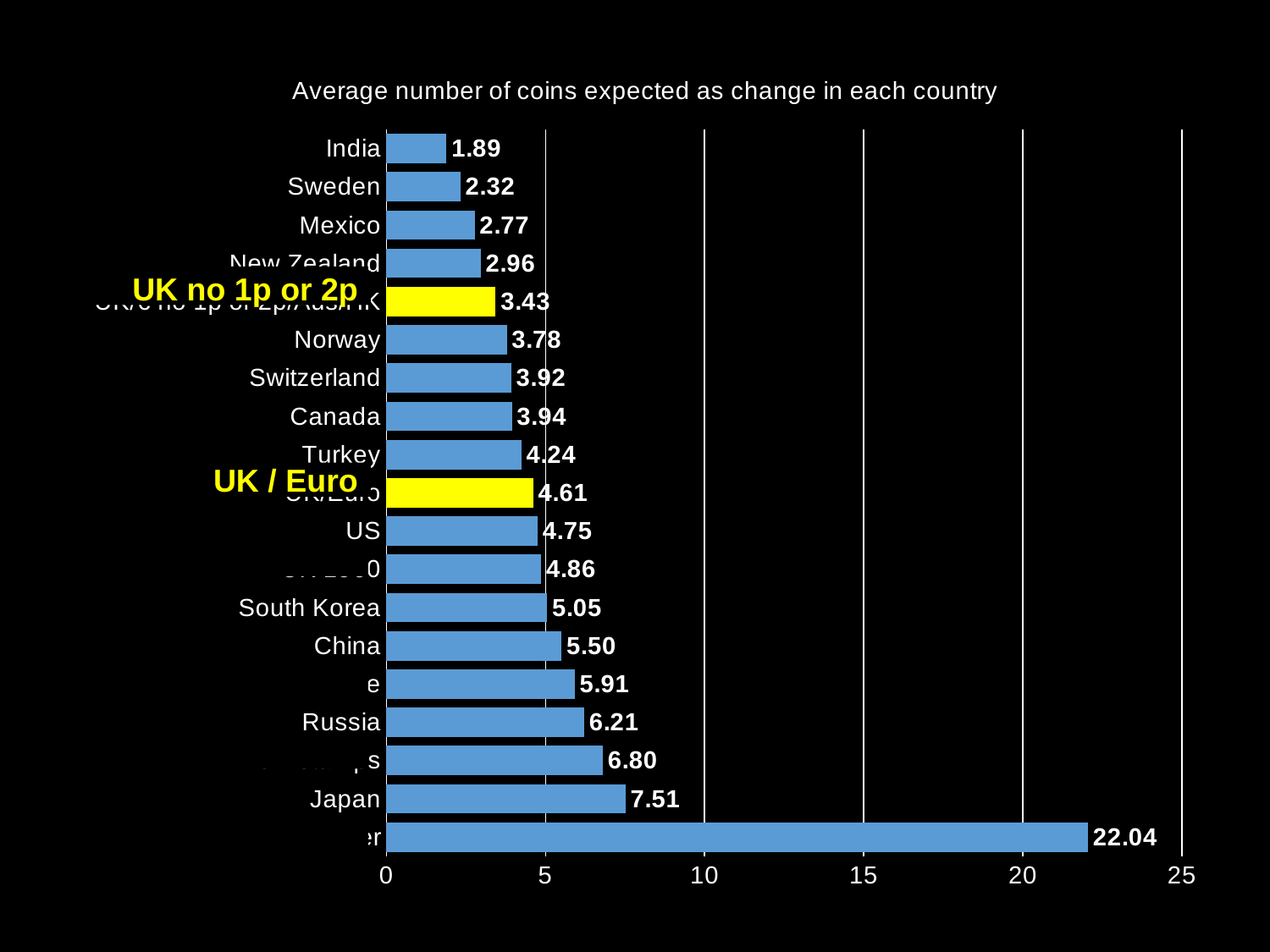
Which country has the lowest average number of coins expected as change? India How many bars are shown on the chart? 19 What is the average number of coins expected as change in India? 1.89 What is the largest value shown on the chart? 22.04 What is the value for the 'UK / Euro' bar? 4.61 What is the difference between the values for Japan and Russia? 1.30 Is the value for Russia greater or less than 5? greater What type of chart is shown on the slide? Bar chart Which has a higher value, China or South Korea? China What is the title of the chart? Average number of coins expected as change in each country What value is shown for Japan? 7.51 What is the value for the 'UK no 1p or 2p' bar? 3.43